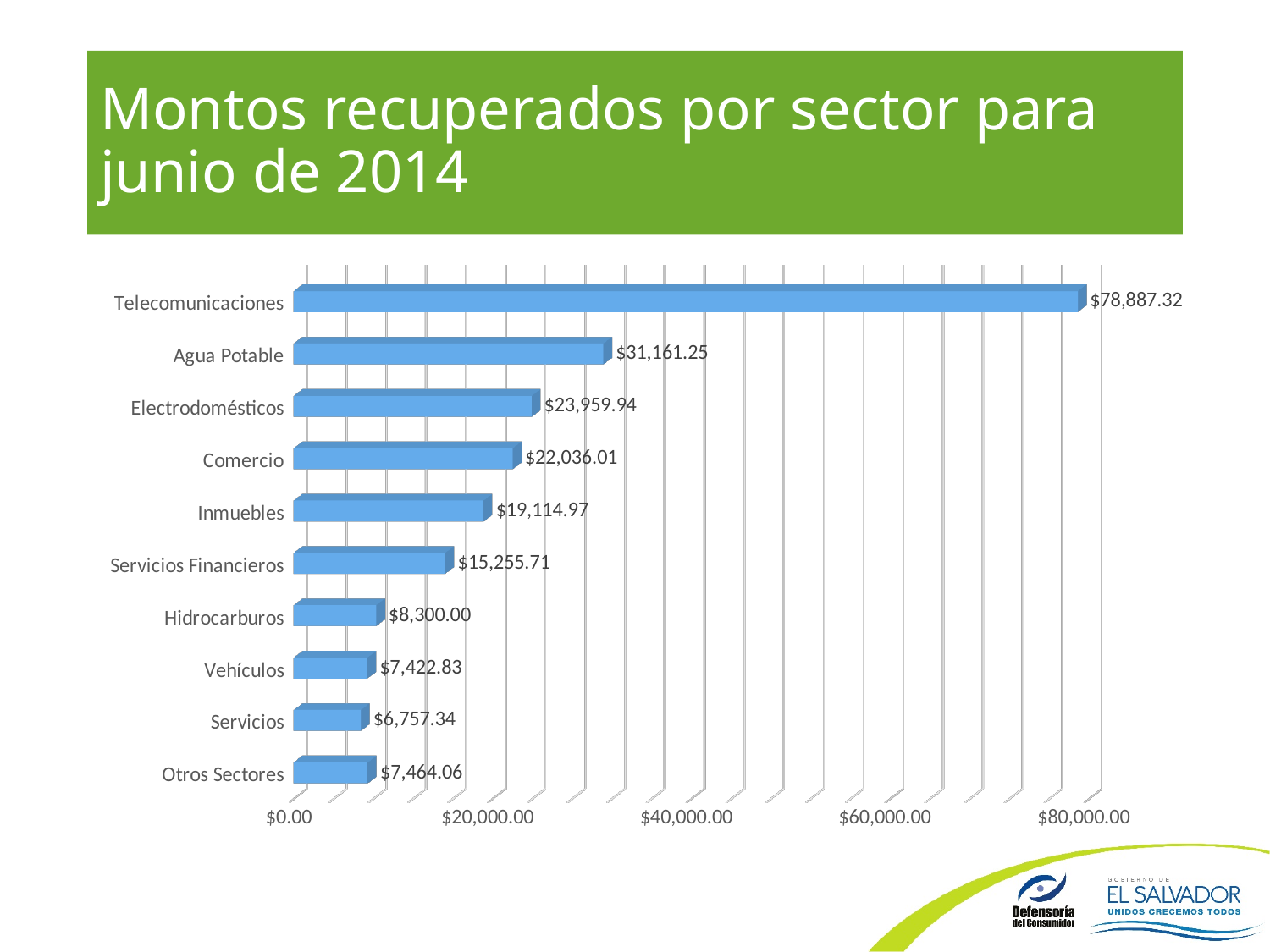
What is the title of the slide? Montos recuperados por sector para junio de 2014 Which sector has the highest recovered amount? Telecomunicaciones What is the value for Telecomunicaciones? $78,887.32 What is the value for Servicios Financieros? $15,255.71 What is the difference between the values for Telecomunicaciones and Agua Potable? $47,726.07 Which is larger, the value for Otros Sectores or the value for Servicios? Otros Sectores How many sectors are shown in the chart? 10 What amount is shown for Agua Potable? $31,161.25 What kind of chart is shown on the slide? bar chart Is the value for Agua Potable greater or less than $20,000.00? greater Which sector has the lowest recovered amount? Servicios What is the difference between the values for Electrodomésticos and Comercio? $1,923.93